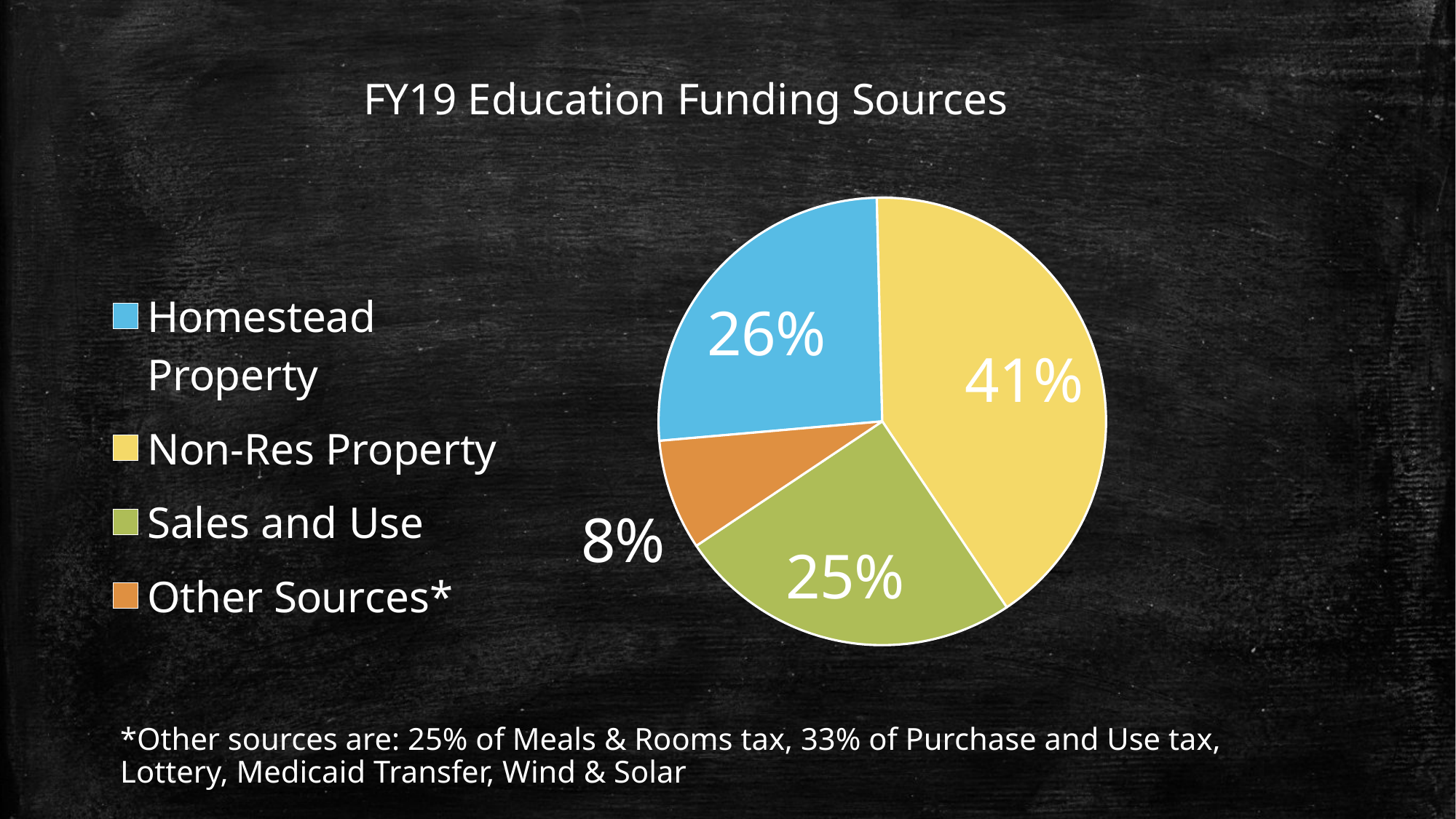
What share of the pie is Homestead Property? 26% Which funding source has the smallest share? Other Sources* Which is larger, the share for Homestead Property or the share for Other Sources*? Homestead Property What is the title of the chart? FY19 Education Funding Sources What is the difference in percentage points between Non-Res Property and Homestead Property? 15 What kind of chart is shown on the slide? pie chart How many slices does the pie chart have? 4 What share of the pie is Non-Res Property? 41% Which funding source has the largest share? Non-Res Property What share of the pie is Other Sources*? 8% Which colour represents Sales and Use in the legend? green